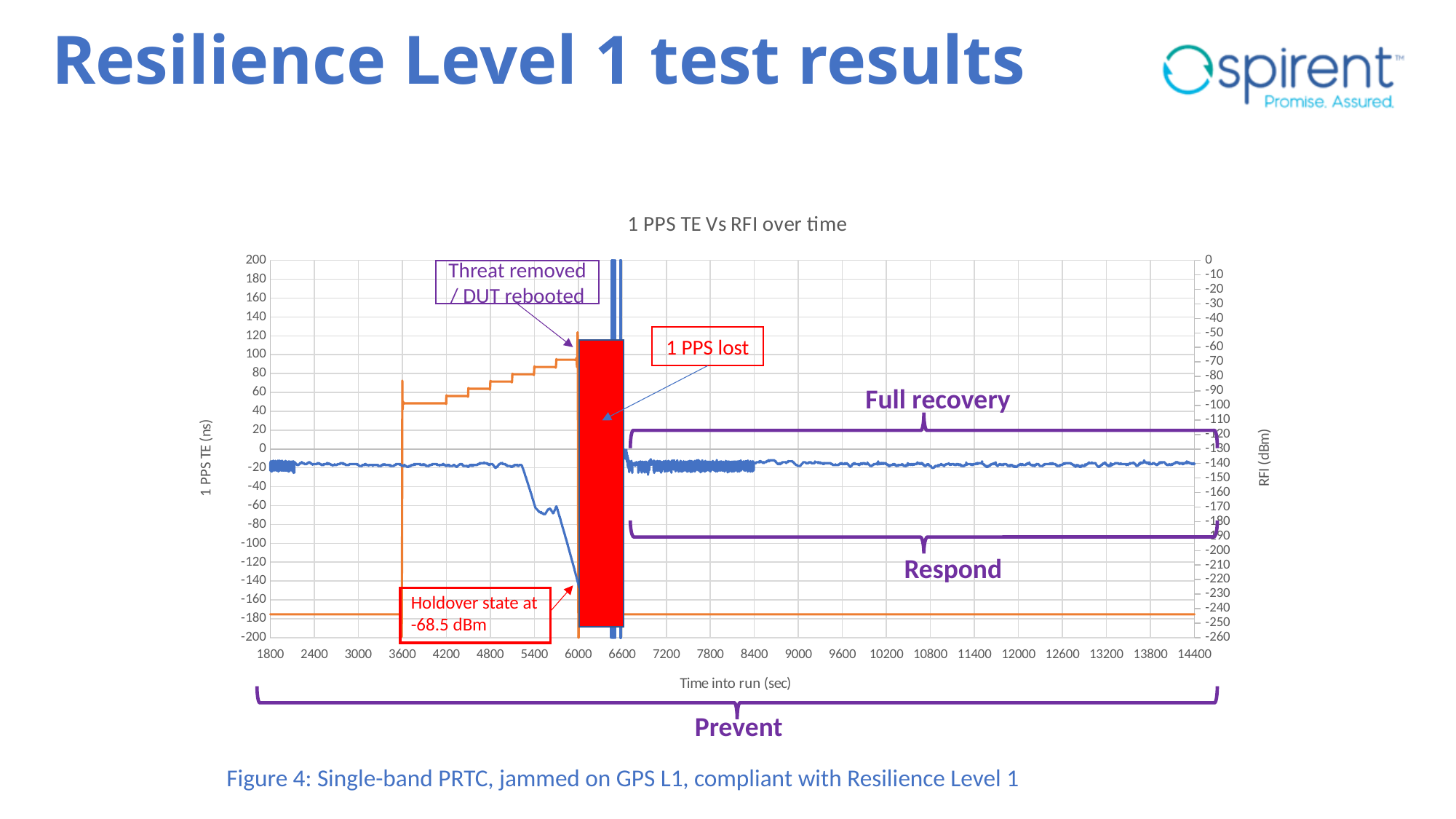
Is the value of the blue 1 PPS TE line at 3000 seconds greater or less than 0 ns? less Does the blue 1 PPS TE line rise or fall between 5400 and 6000 seconds into the run? fall What is the title of the chart? 1 PPS TE Vs RFI over time Is the value of the blue 1 PPS TE line at 12000 seconds greater or less than -100 ns? greater Does the orange RFI line rise or fall between 3600 and 6000 seconds into the run? rise Is the value of the orange RFI line at 9000 seconds greater or less than -200 dBm? less What does the annotation with the purple box at the top of the chart say? Threat removed / DUT rebooted According to the annotation on the chart, at what RFI level does the holdover state occur? -68.5 dBm How many tick labels are shown on the x axis (Time into run)? 22 What kind of chart is shown on the slide? line chart